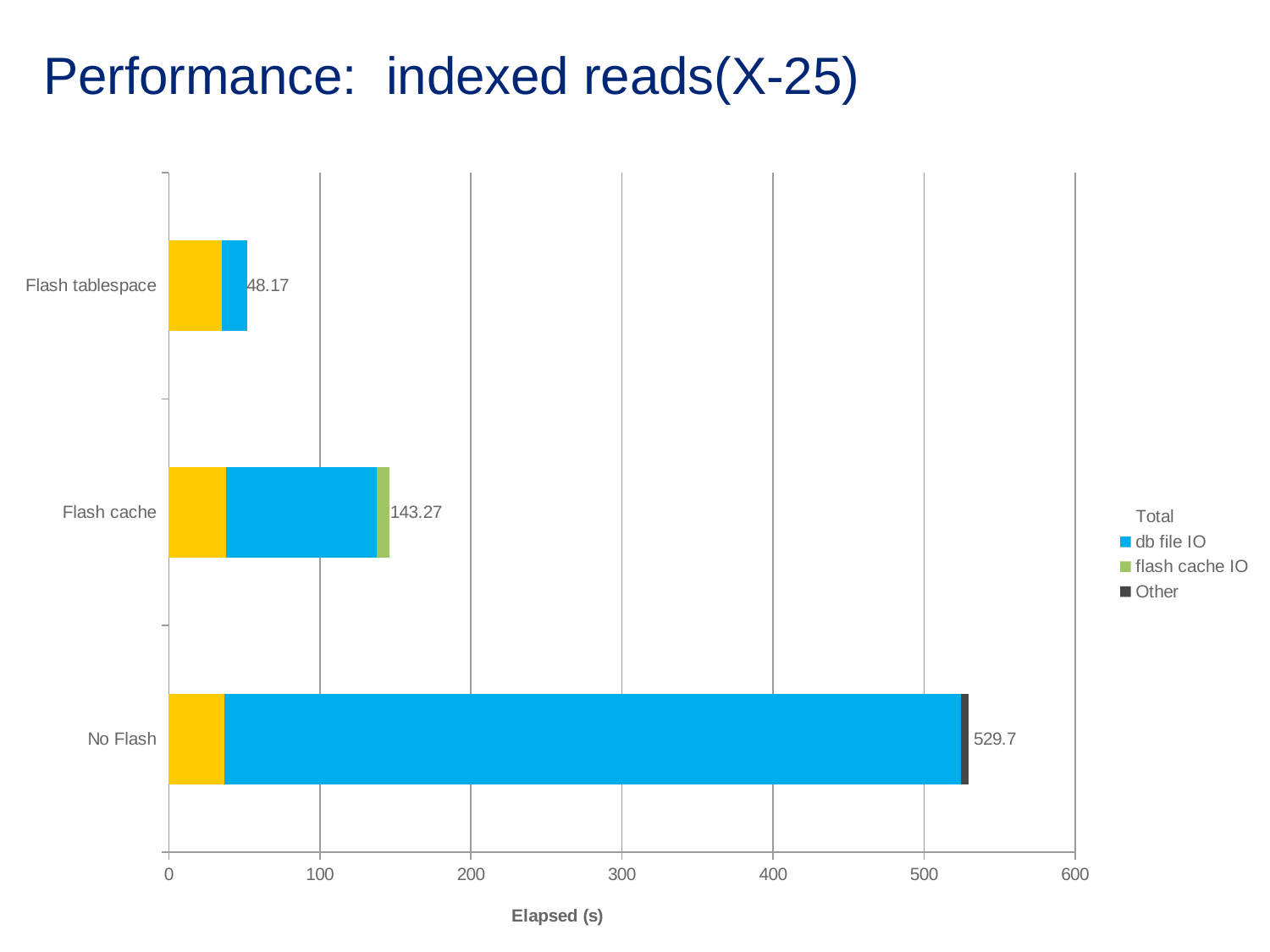
How many categories are plotted on the chart? 3 Which has a larger total elapsed time, Flash cache or Flash tablespace? Flash cache What is the total value labelled for the Flash cache bar? 143.27 What is the title of the horizontal axis? Elapsed (s) What is the total value labelled for the No Flash bar? 529.7 What is the total value labelled for the Flash tablespace bar? 48.17 What is the difference between the Flash cache total and the Flash tablespace total? 95.1 Which category has the lowest total elapsed time? Flash tablespace Which category has the highest total elapsed time? No Flash Is the total for No Flash greater or less than 500? greater What kind of chart is shown on the slide? Stacked bar chart What is the difference between the No Flash total and the Flash tablespace total? 481.53